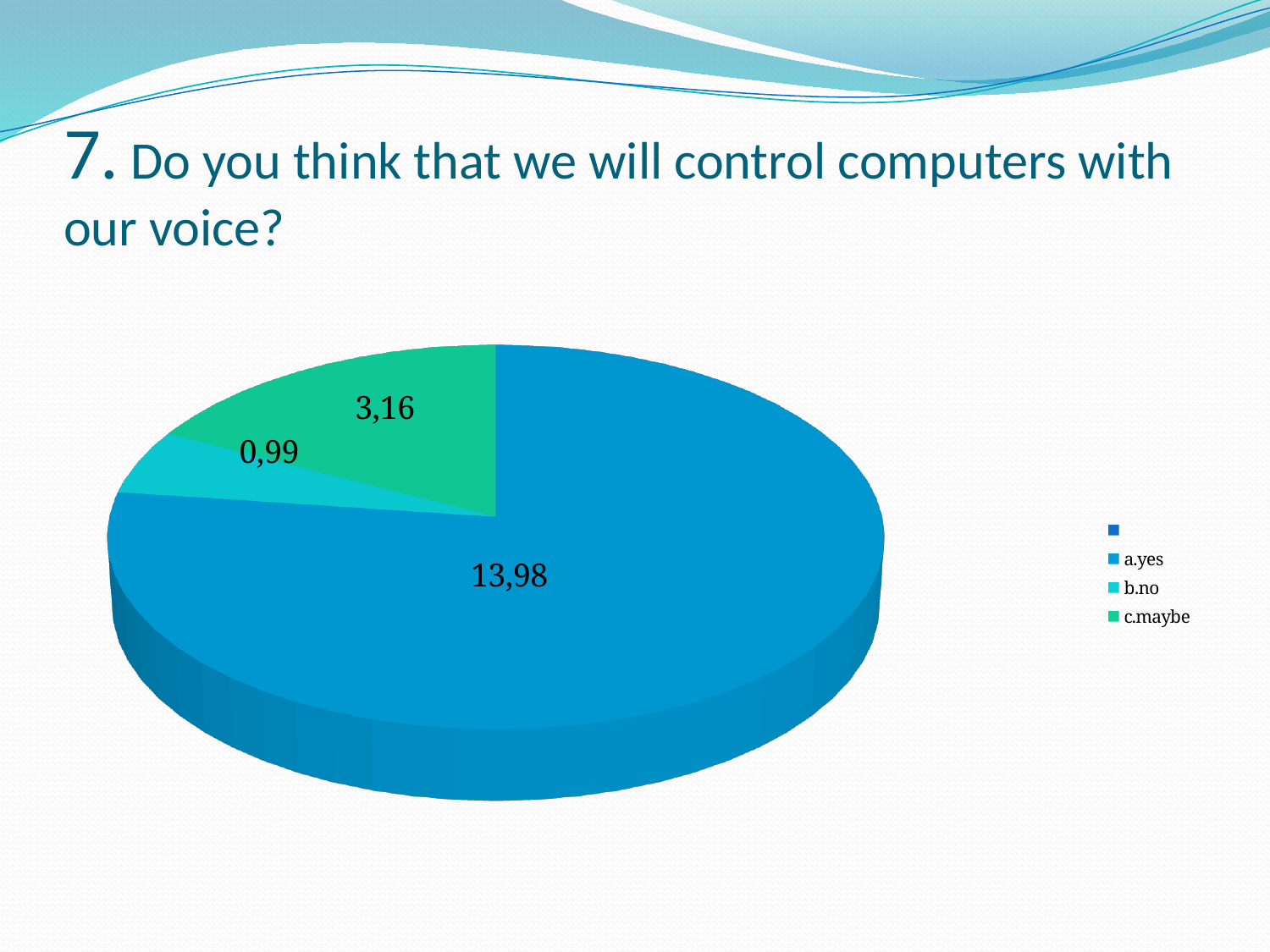
What colour is the c.maybe slice in the pie chart? Green Which answer option has the largest slice in the pie chart? a.yes Which answer option has the smallest slice in the pie chart? b.no What kind of chart is shown on the slide? Pie chart How many slices does the pie chart have? 3 What value is shown for the a.yes slice of the pie chart? 13,98 What value is shown for the c.maybe slice of the pie chart? 3,16 What is the difference between the values for c.maybe and b.no? 2,17 Which is larger, the value for c.maybe or the value for b.no? c.maybe What value is shown for the b.no slice of the pie chart? 0,99 What is the difference between the values for a.yes and c.maybe? 10,82 What is the total of all the values shown on the pie chart? 18,13